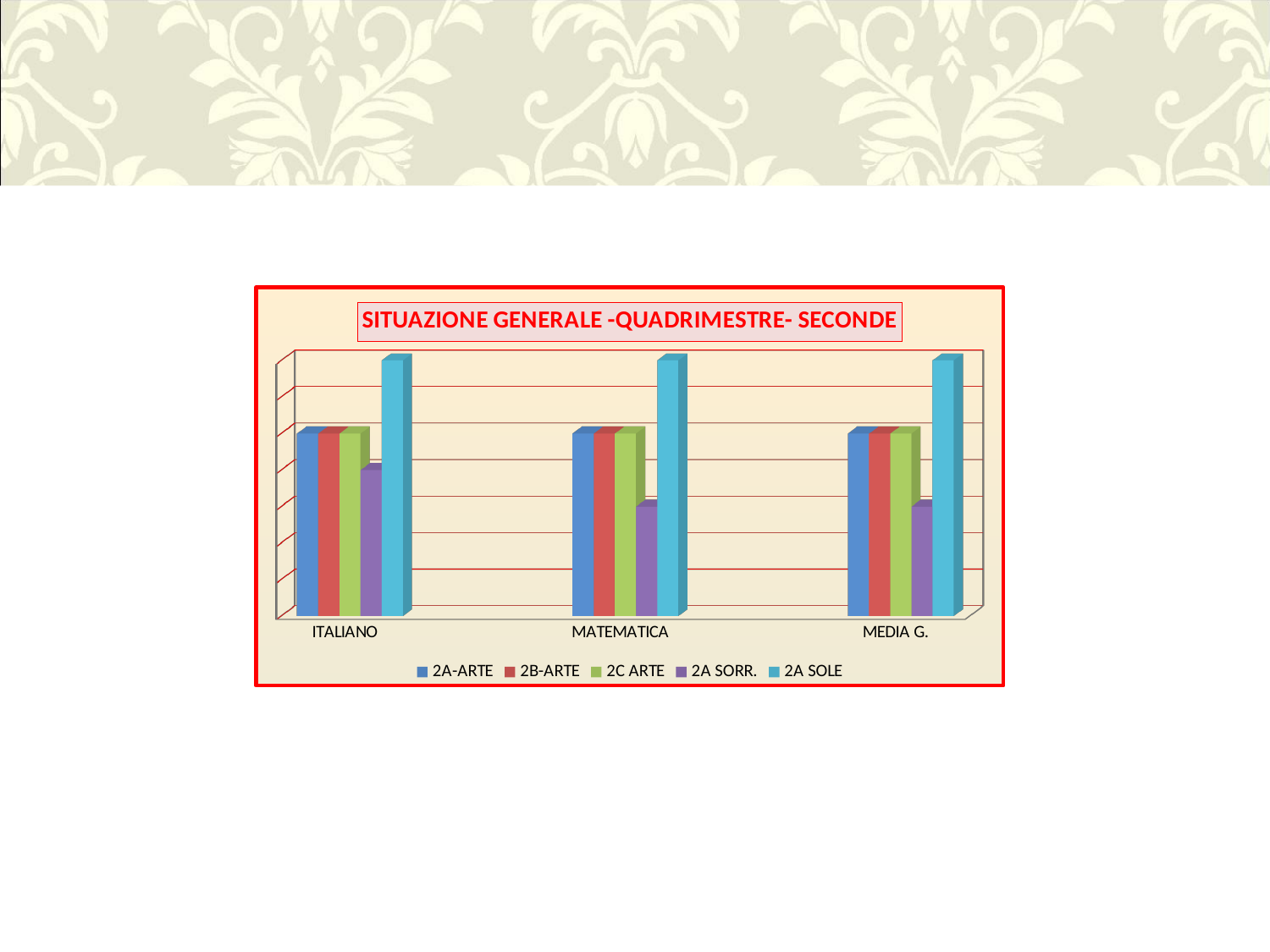
For MATEMATICA, which is larger: the value for 2A SOLE or the value for 2A SORR.? 2A SOLE In which category does the 2A SORR. series reach its highest value? ITALIANO What is the title of the chart? SITUAZIONE GENERALE -QUADRIMESTRE- SECONDE Which series has the lowest value for ITALIANO? 2A SORR. What kind of chart is shown on the slide? bar chart How many series does the chart's legend list? 5 Which series has the lowest value for MATEMATICA? 2A SORR. How many categories are shown on the x axis of the chart? 3 Which series has the highest value for MEDIA G.? 2A SOLE Which series has the highest value for ITALIANO? 2A SOLE Which series are listed in the chart's legend? 2A-ARTE, 2B-ARTE, 2C ARTE, 2A SORR., 2A SOLE For ITALIANO, which is larger: the value for 2A-ARTE or the value for 2A SORR.? 2A-ARTE